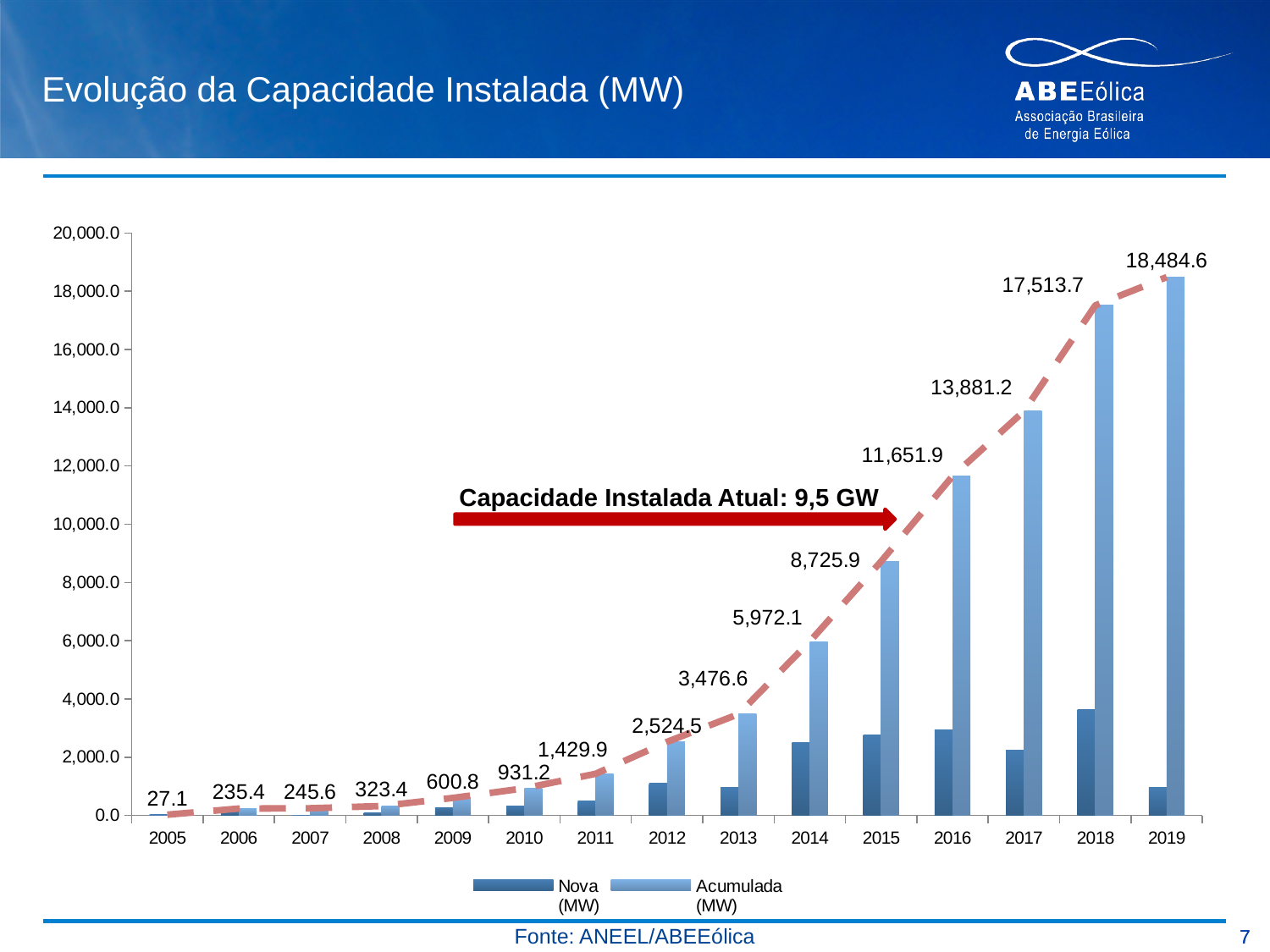
How many series does the legend list? 2 Is the Nova (MW) value for 2018 greater or less than 2,000.0? greater What is the Acumulada (MW) value for 2019? 18,484.6 Which year has the lowest Acumulada (MW) value? 2005 Does the Acumulada (MW) series rise or fall from 2005 to 2019? Rises What is the difference between the Acumulada (MW) values for 2019 and 2018? 970.9 What is the Acumulada (MW) value for 2015? 8,725.9 How many years are shown on the x axis? 15 What kind of chart is shown on the slide? Combination bar and line chart What is the Acumulada (MW) value for 2010? 931.2 Which year has the highest Acumulada (MW) value? 2019 Which year has the larger Acumulada (MW) value, 2012 or 2013? 2013